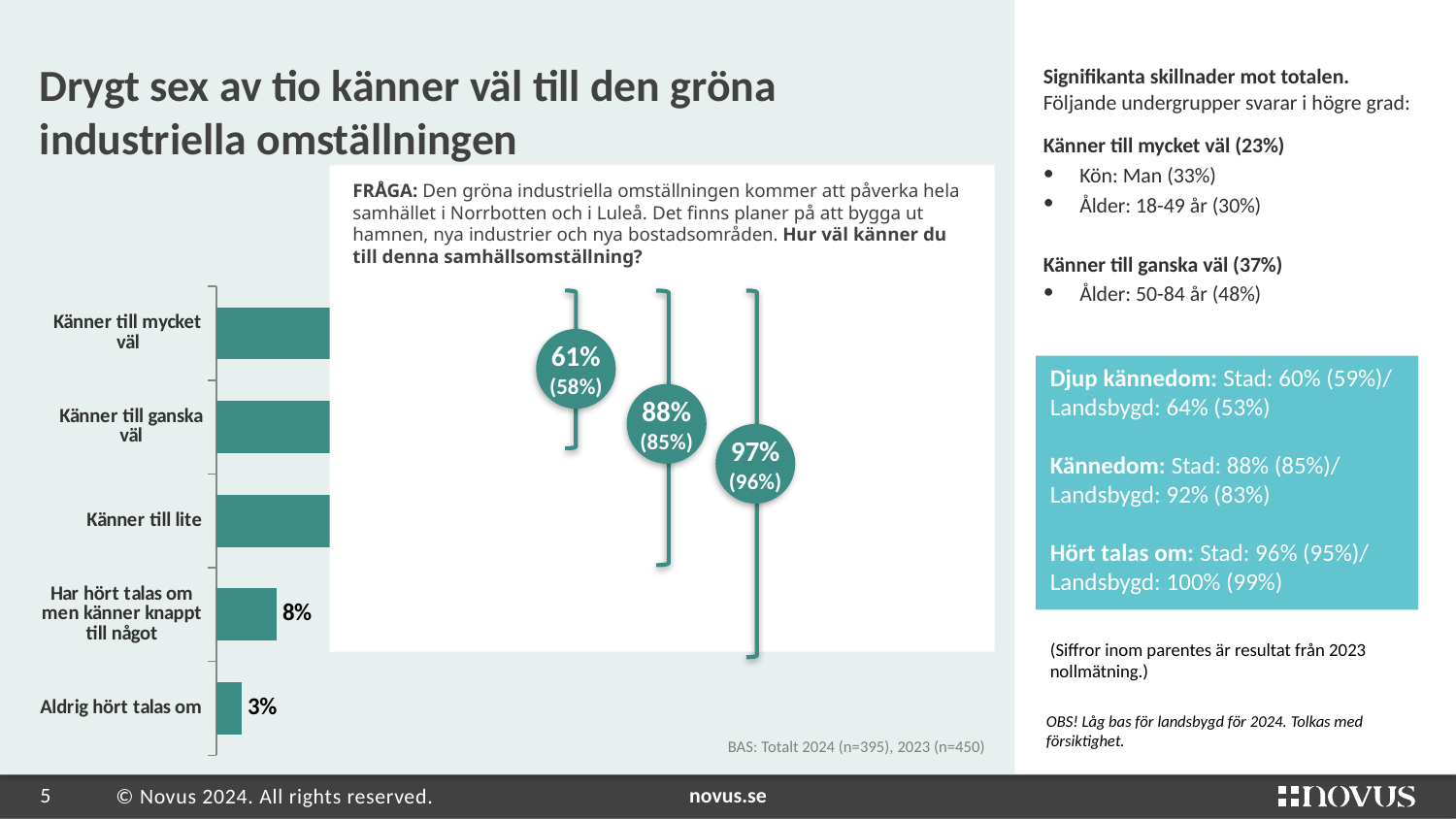
How many categories are shown in the bar chart? 5 What is the value for 'Aldrig hört talas om'? 3% What is the value for 'Har hört talas om men känner knappt till något'? 8% Which is larger: 'Har hört talas om men känner knappt till något' or 'Aldrig hört talas om'? Har hört talas om men känner knappt till något What is the 2024 sample size (n) stated in the BAS note under the chart? n=395 Which is larger: 'Känner till lite' or 'Aldrig hört talas om'? Känner till lite Which category has the lowest value in the bar chart? Aldrig hört talas om Which is larger: 'Känner till mycket väl' or 'Har hört talas om men känner knappt till något'? Känner till mycket väl What is the difference between the values for 'Har hört talas om men känner knappt till något' and 'Aldrig hört talas om'? 5 percentage points What kind of chart is shown on the slide? Bar chart